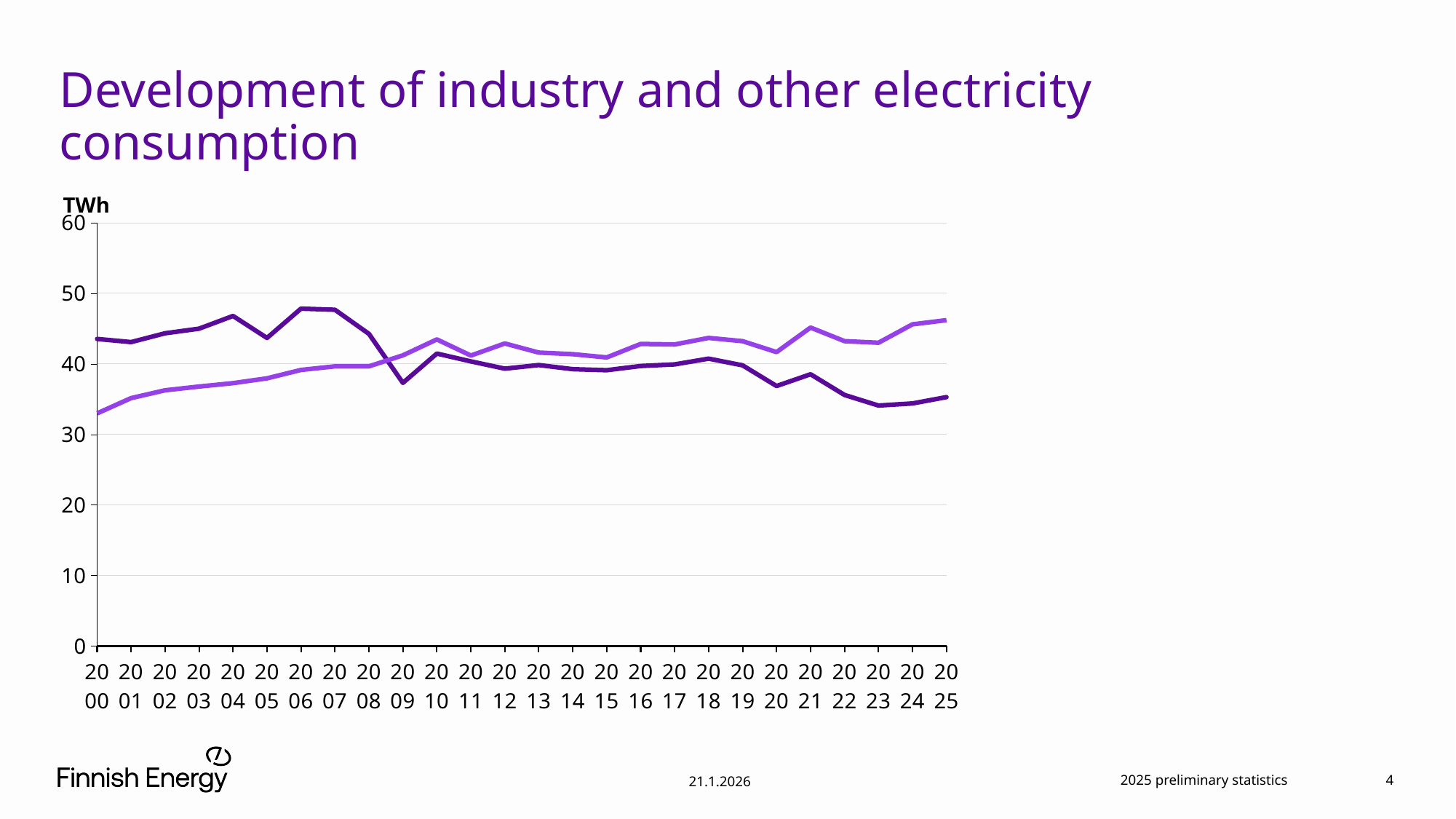
What is the title of the chart on the slide? Development of industry and other electricity consumption What unit is shown on the y axis of the chart? TWh In 2000, which line has the higher value, the dark purple line or the light purple line? The dark purple line How many lines are plotted on the chart? 2 Is the value of the dark purple line in 2023 greater or less than 40? less How many years are shown on the x axis of the chart? 26 In 2025, which line has the higher value, the dark purple line or the light purple line? The light purple line Does the light purple line overall rise or fall from 2000 to 2025? Rise What kind of chart is shown on the slide? Line chart Is the value of the light purple line in 2025 greater or less than 40? greater Is the value of the light purple line in 2000 greater or less than 35? less